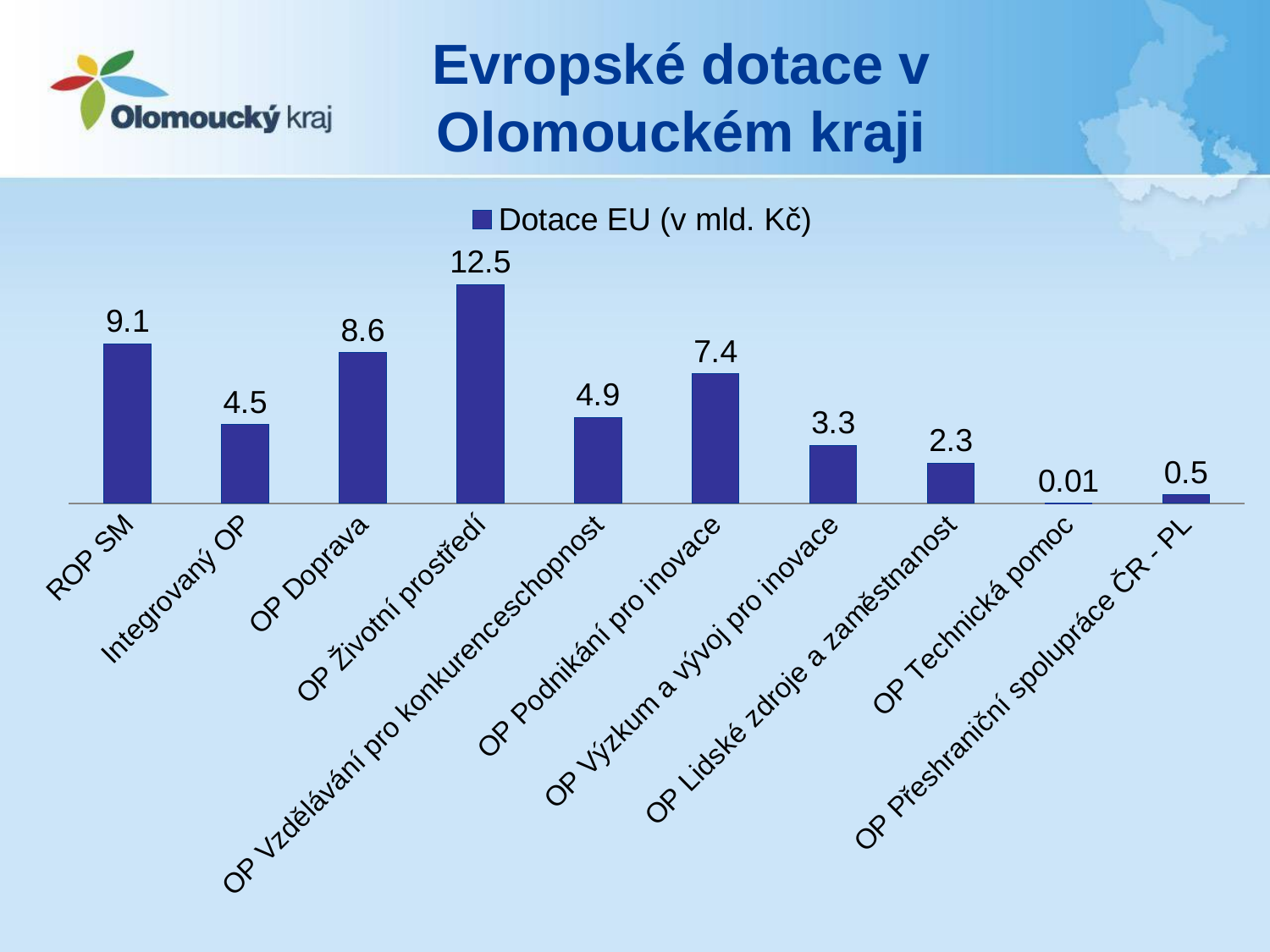
How many series does the legend list? 1 What is the value for OP Lidské zdroje a zaměstnanost? 2.3 Which category has the highest value? OP Životní prostředí What is the difference between the values for OP Životní prostředí and OP Podnikání pro inovace? 5.1 Which is larger, the value for OP Vzdělávání pro konkurenceschopnost or the value for OP Výzkum a vývoj pro inovace? OP Vzdělávání pro konkurenceschopnost What is the value for OP Přeshraniční spolupráce ČR - PL? 0.5 What kind of chart is shown on the slide? Bar chart What is the legend entry of the series shown in the chart? Dotace EU (v mld. Kč) How many categories are shown in the chart? 10 What is the difference between the values for ROP SM and Integrovaný OP? 4.6 What is the value for OP Doprava? 8.6 Which category has the lowest value? OP Technická pomoc